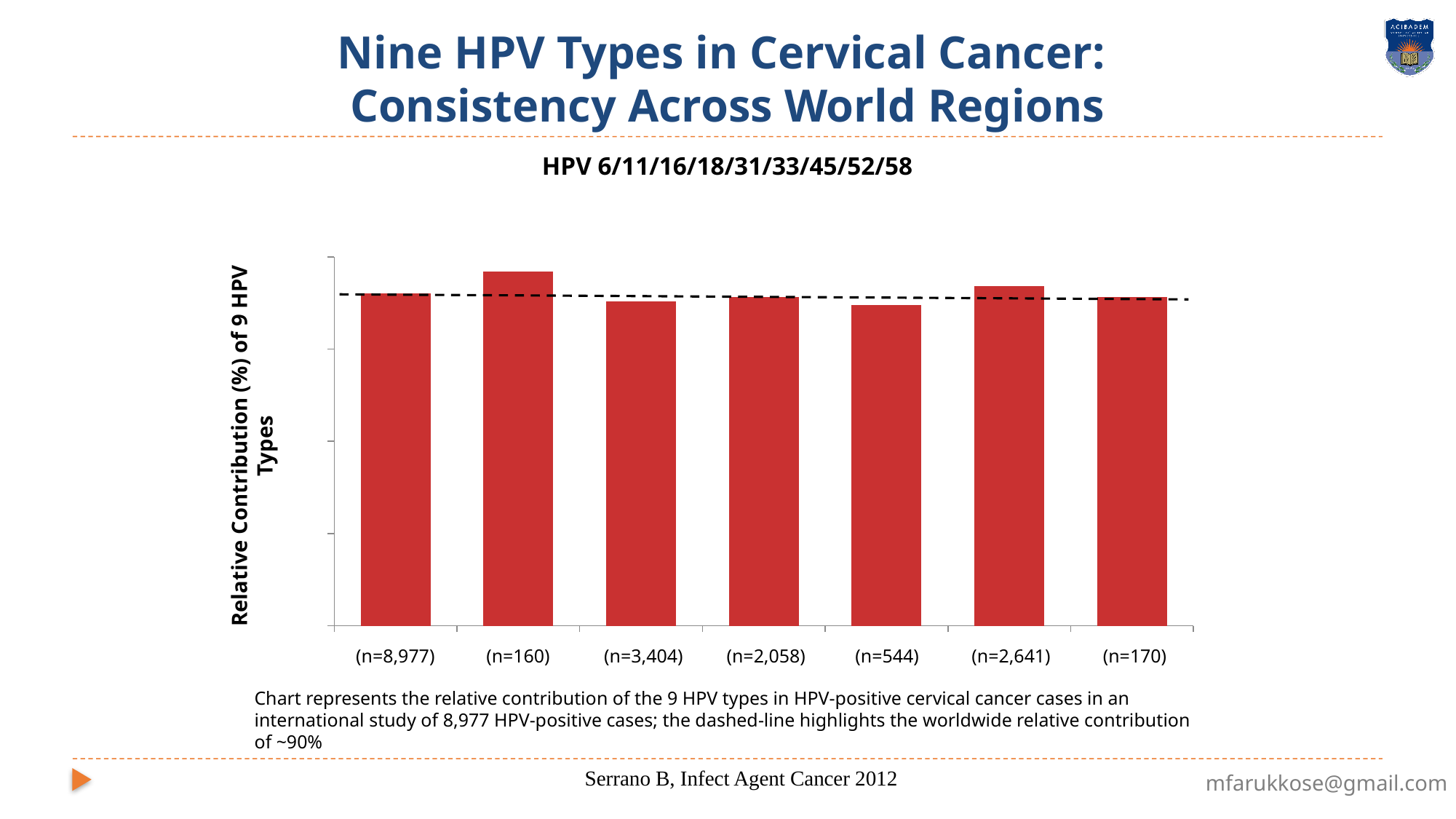
How many bars are plotted in the chart? 7 Which bar is taller, the one for (n=2,641) or the one for (n=544)? (n=2,641) What is the label of the y axis of the chart? Relative Contribution (%) of 9 HPV Types What kind of chart is shown on the slide? bar chart What colour are the bars in the chart? red Which bar is taller, the one for (n=160) or the one for (n=544)? (n=160) Which category has the highest bar in the chart? (n=160) Which bar is taller, the one for (n=160) or the one for (n=2,641)? (n=160)